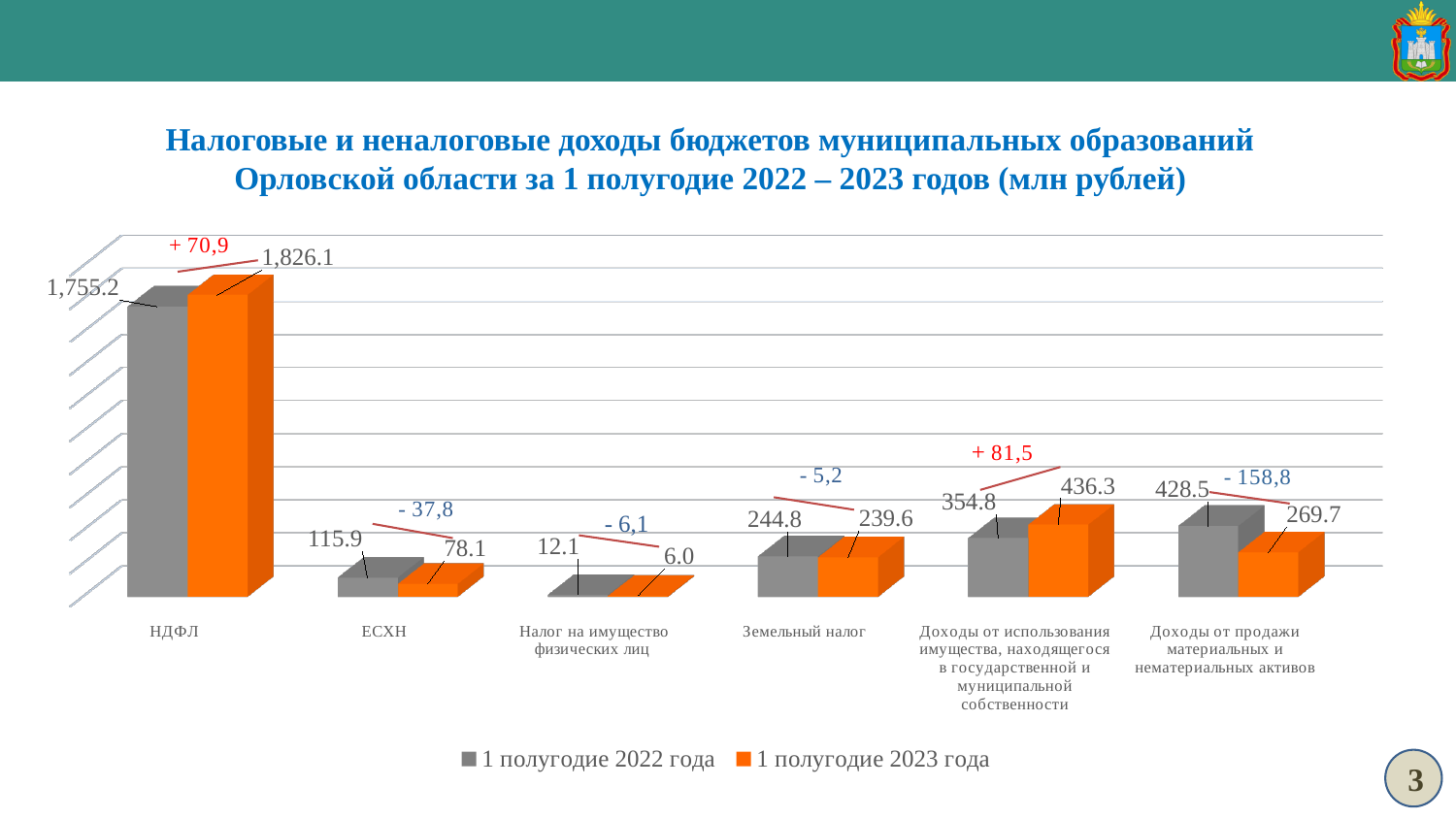
Which colour represents the series 1 полугодие 2023 года? Orange What is the value for Налог на имущество физических лиц in the series 1 полугодие 2022 года? 12.1 Which category has the lowest value in the series 1 полугодие 2023 года? Налог на имущество физических лиц Which category has the highest value in the series 1 полугодие 2022 года? НДФЛ What is the value for НДФЛ in the series 1 полугодие 2023 года? 1,826.1 Which is larger for Доходы от продажи материальных и нематериальных активов: the value for 1 полугодие 2022 года or for 1 полугодие 2023 года? 1 полугодие 2022 года What kind of chart is shown on the slide? Bar chart What is the value for Земельный налог in the series 1 полугодие 2023 года? 239.6 How many series does the legend list? 2 How many categories are shown on the x axis of the chart? 6 What is the difference between the 2023 and 2022 values for Доходы от использования имущества, находящегося в государственной и муниципальной собственности? 81.5 What is the value for ЕСХН in the series 1 полугодие 2022 года? 115.9